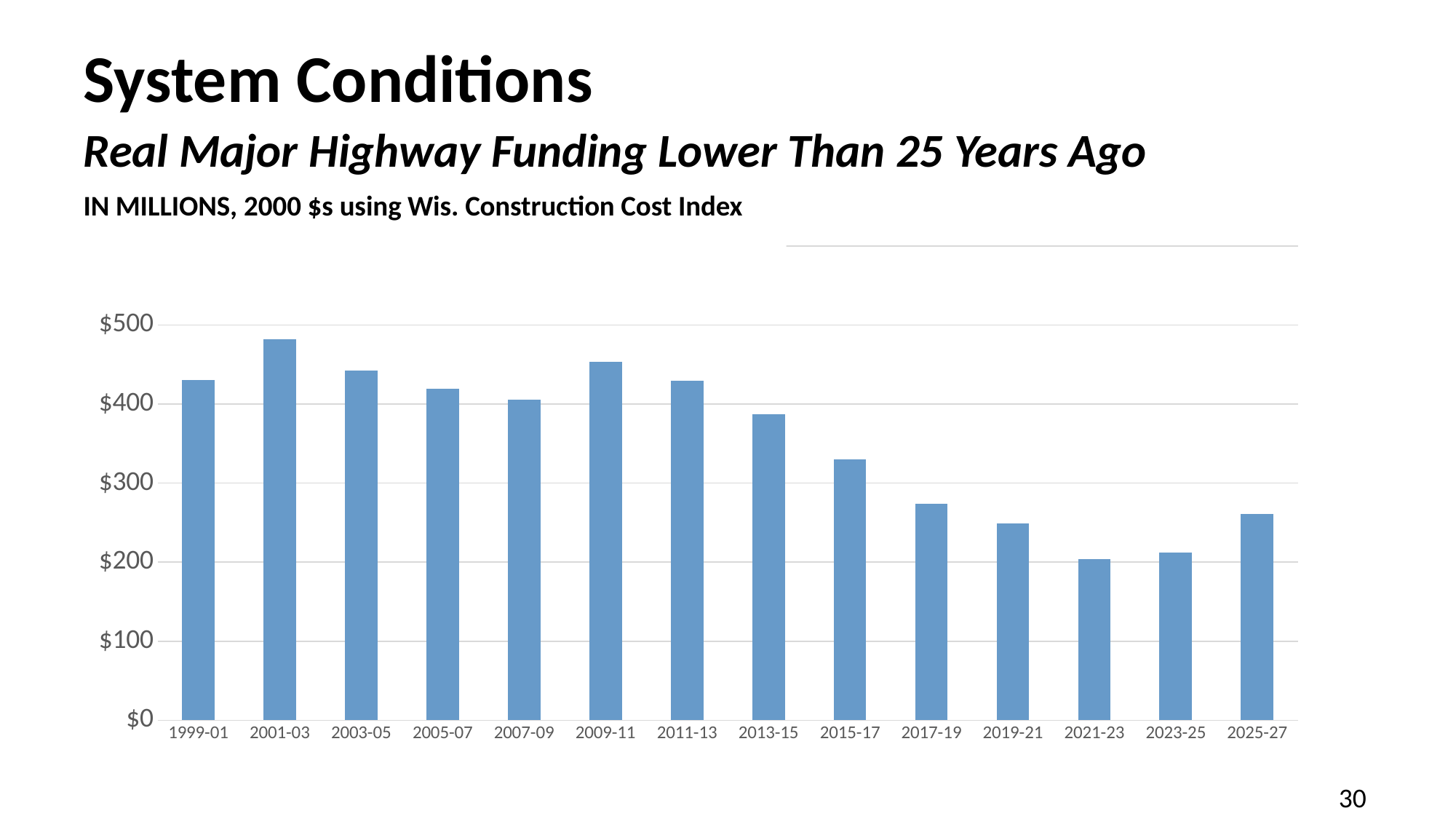
Overall, do the values rise or fall from 1999-01 to 2025-27? fall Is the value for 2015-17 greater or less than $300? greater In what units are the chart values expressed, according to the subtitle? Millions, 2000 $s using Wis. Construction Cost Index Is the value for 2009-11 greater or less than $400? greater Which biennium has the lowest real major highway funding? 2021-23 Is the value for 2001-03 greater or less than $500? less How many biennia (bars) are shown on the chart? 14 What kind of chart is shown on the slide? bar chart Which biennium has the highest real major highway funding? 2001-03 Which is larger, the value for 2009-11 or the value for 2013-15? 2009-11